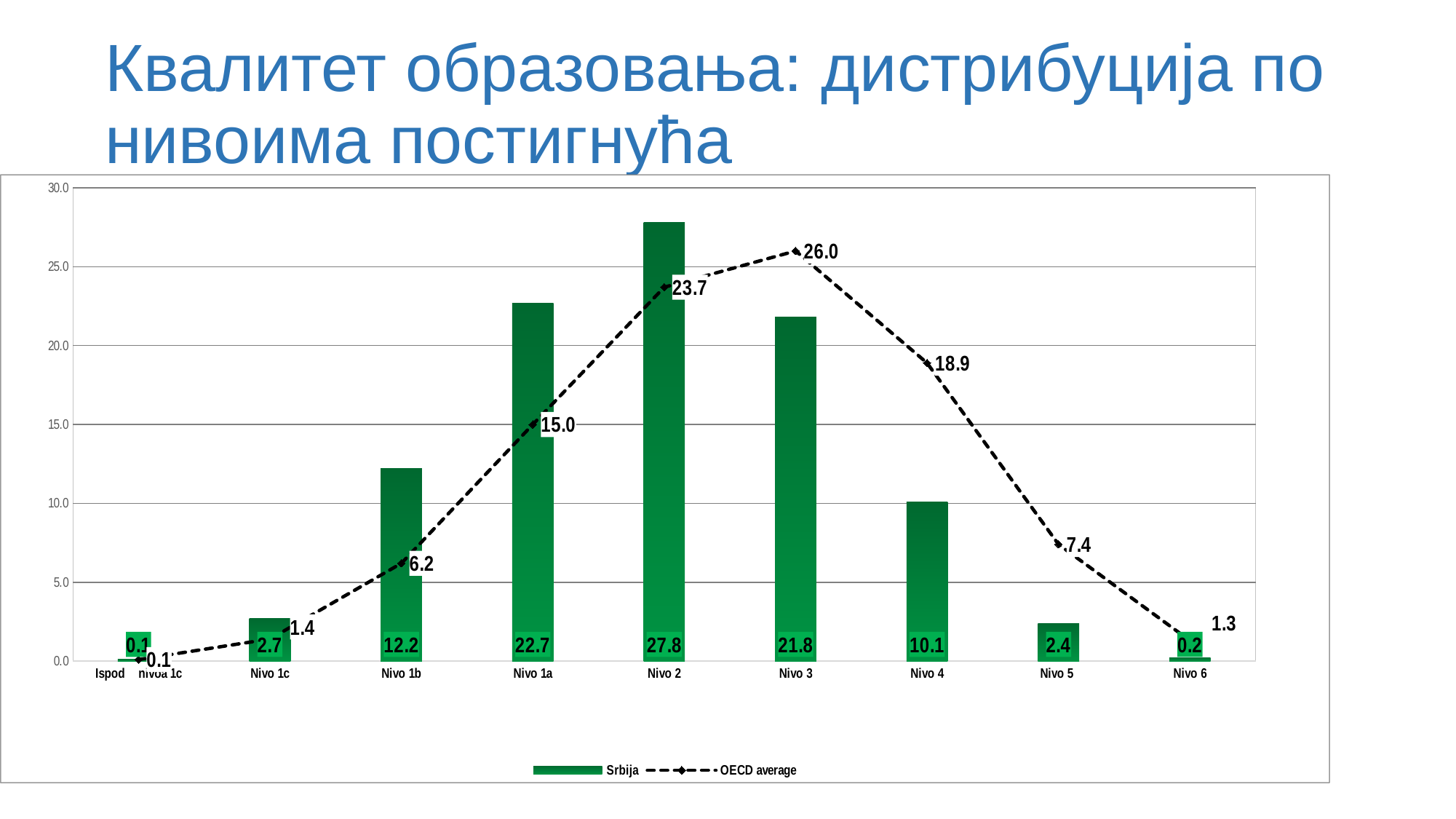
How many achievement levels are shown on the x axis? 9 What is the value for Srbija at Nivo 1b? 12.2 Which series is drawn as a dashed line? OECD average At which level is the OECD average value highest? Nivo 3 What kind of chart is shown on the slide? Combined bar and line chart What is the OECD average value at Nivo 3? 26.0 What is the difference between the Srbija value and the OECD average at Nivo 1a? 7.7 At which level is the Srbija value highest? Nivo 2 What is the OECD average value at Nivo 5? 7.4 How many series does the legend list? 2 What is the value for Srbija at Nivo 2? 27.8 At Nivo 4, which is larger: the Srbija value or the OECD average? OECD average